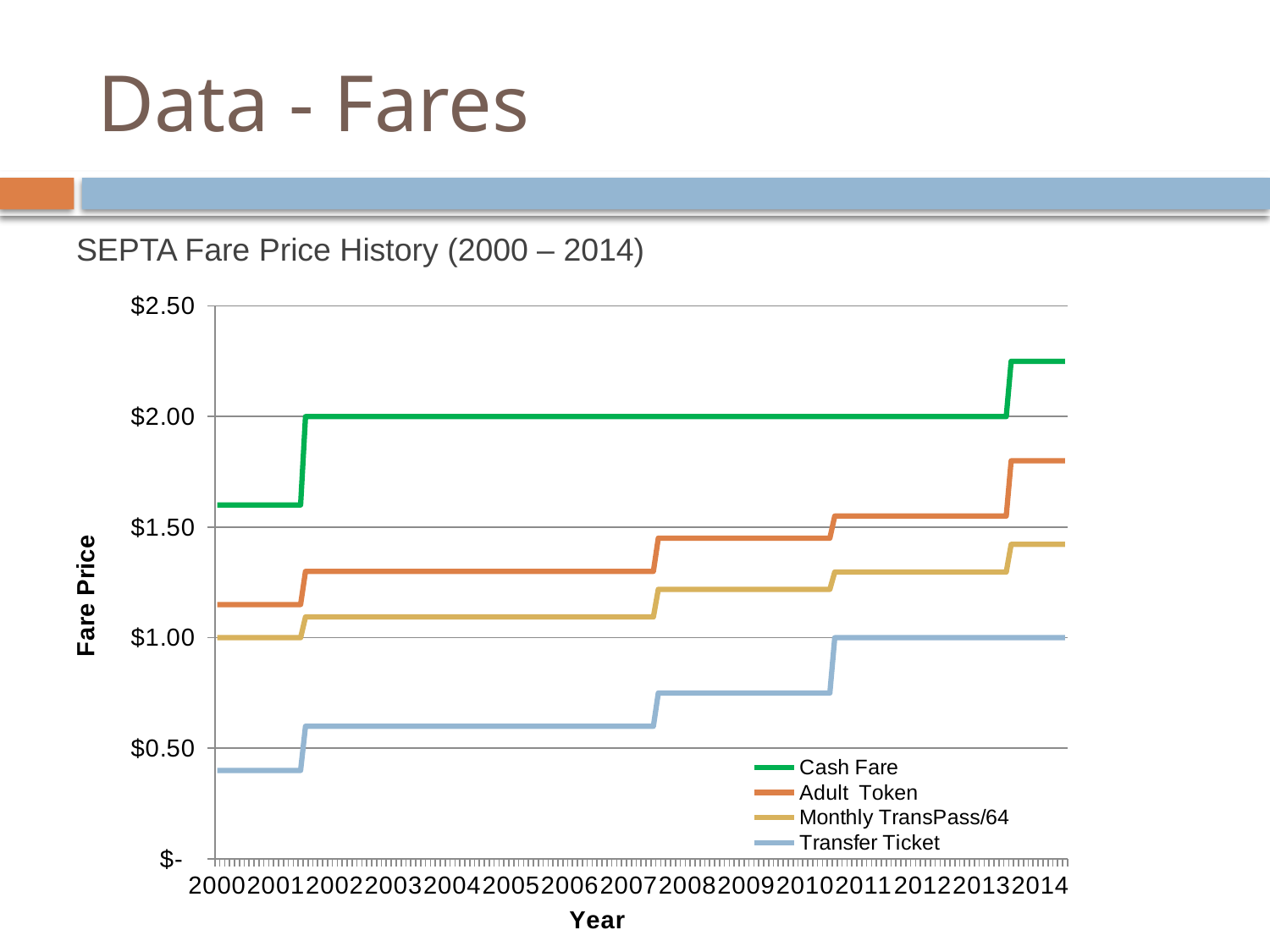
Is the Transfer Ticket price in 2000 greater or less than $0.50? less Do fare prices rise or fall over the years shown? rise What was the Monthly TransPass/64 price in 2000? $1.00 How many series does the legend list? 4 What kind of chart is shown on the slide? line chart What is the label of the y axis? Fare Price What was the Cash Fare in 2005? $2.00 Which series has the highest fare price throughout the period? Cash Fare What was the Transfer Ticket price in 2012? $1.00 Which series has the lowest fare price throughout the period? Transfer Ticket Is the Cash Fare in 2014 greater or less than $2.00? greater Is the Adult Token price in 2014 greater or less than $2.00? less